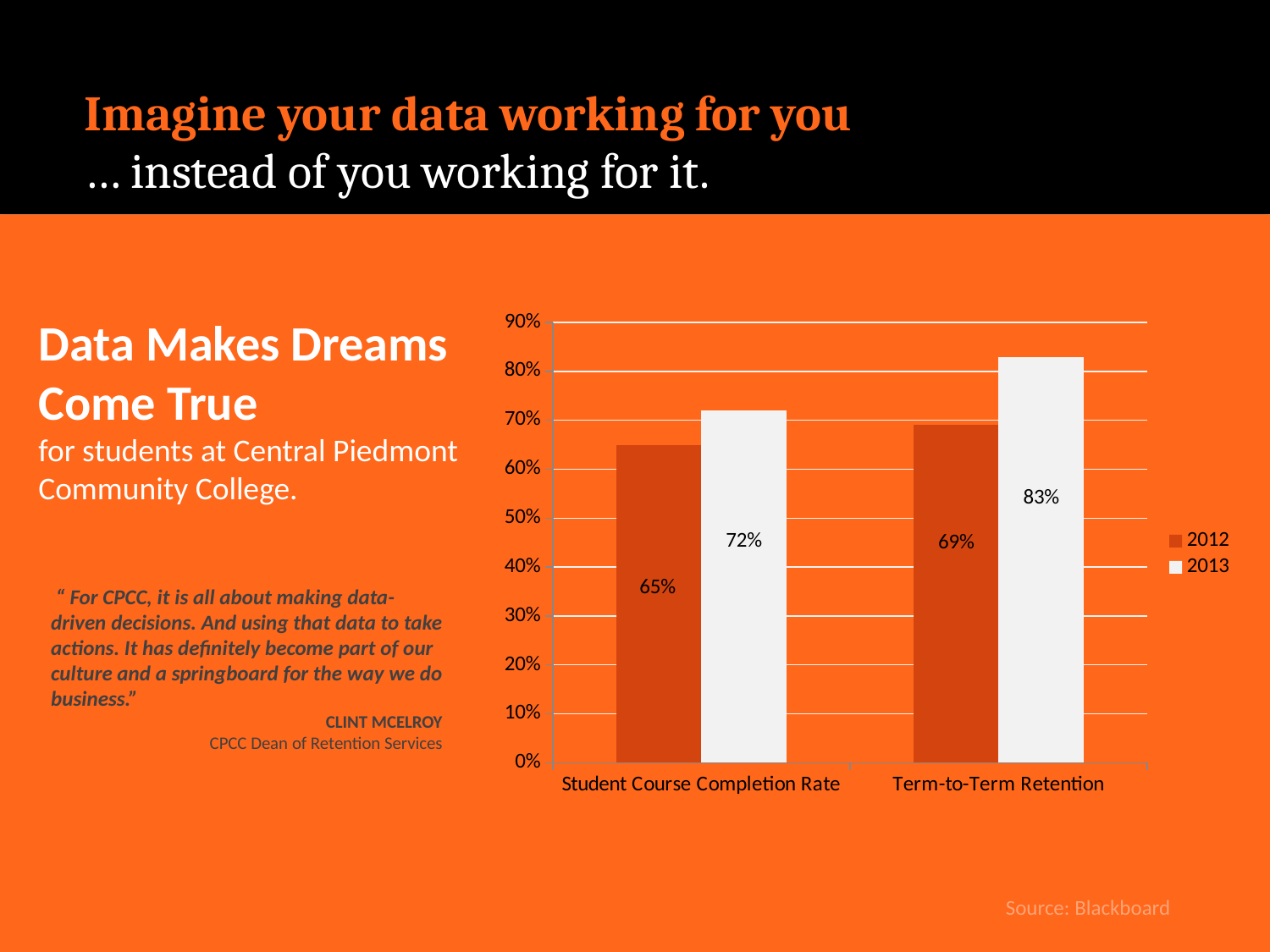
What is the difference between the 2013 and 2012 values for Student Course Completion Rate? 7% Which category has the lowest 2012 value? Student Course Completion Rate What is the 2012 value for Student Course Completion Rate? 65% How many categories are shown on the x axis? 2 How many series does the legend list? 2 What is the 2012 value for Term-to-Term Retention? 69% What is the 2013 value for Student Course Completion Rate? 72% What kind of chart is shown on the slide? Bar chart What is the 2013 value for Term-to-Term Retention? 83% Which is larger: the 2012 value for Term-to-Term Retention or the 2013 value for Student Course Completion Rate? 2013 value for Student Course Completion Rate Which category has the highest 2013 value? Term-to-Term Retention What is the difference between the 2013 and 2012 values for Term-to-Term Retention? 14%